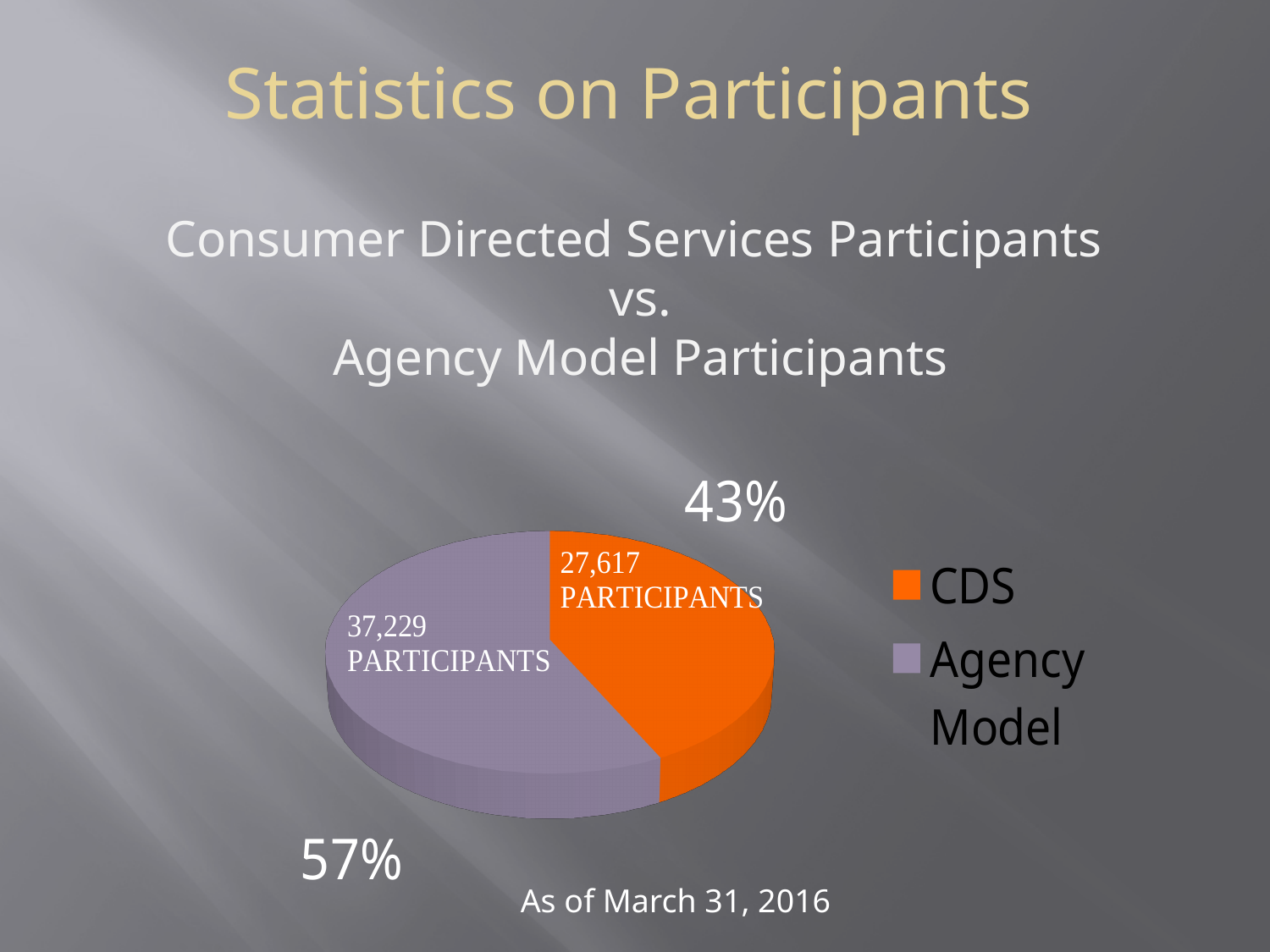
How many participants are in the CDS slice of the pie chart? 27,617 How many entries does the legend of the pie chart list? 2 Which slice of the pie chart is the smallest? CDS What percentage share of the pie does the Agency Model slice represent? 57% How many slices does the pie chart have? 2 Which has more participants, CDS or Agency Model? Agency Model What percentage share of the pie does the CDS slice represent? 43% Which slice of the pie chart is the largest? Agency Model What colour is the CDS slice in the pie chart? Orange What is the difference in participants between the Agency Model and CDS slices? 9,612 What kind of chart is shown on the slide? Pie chart How many participants are in the Agency Model slice of the pie chart? 37,229